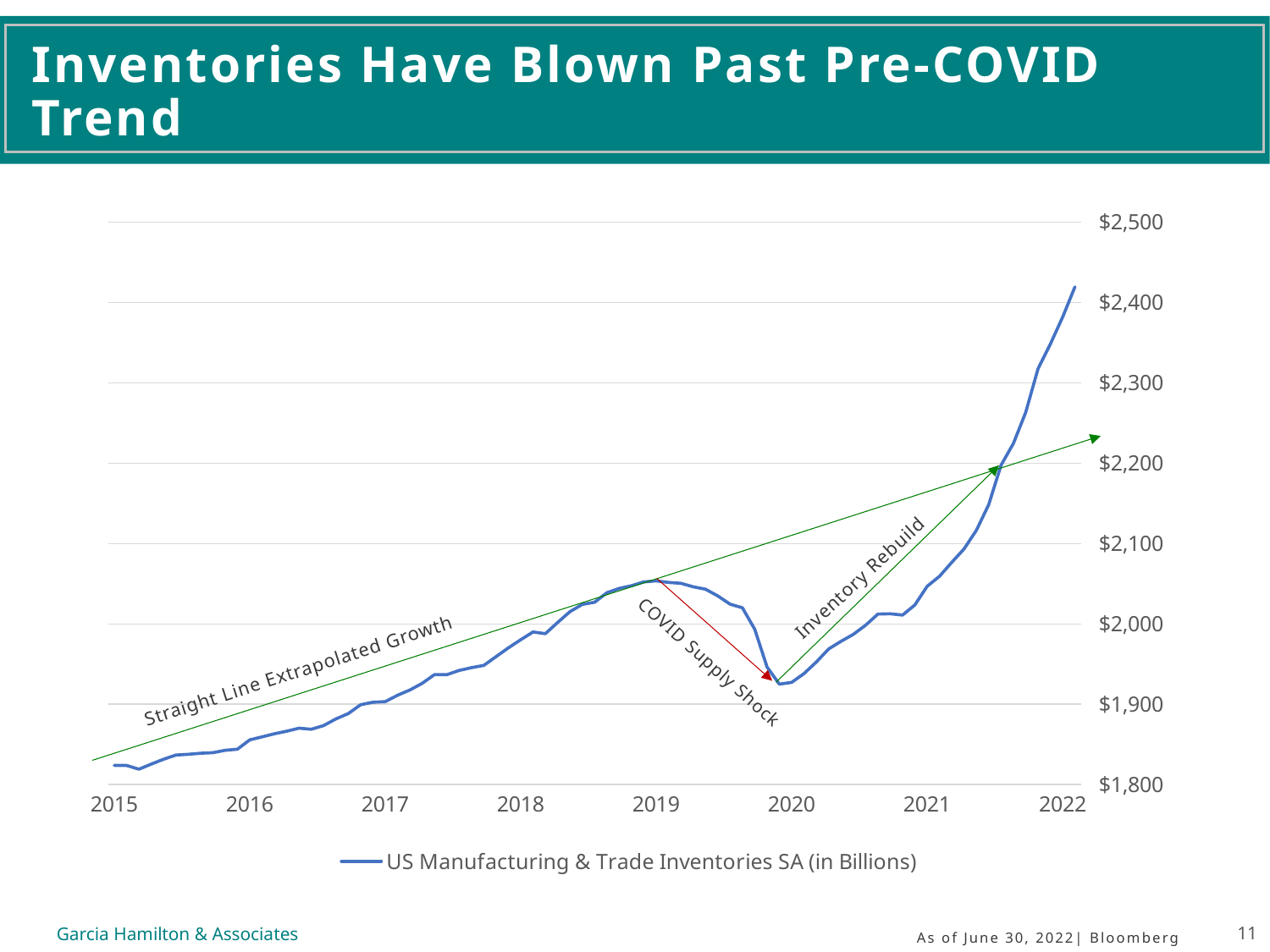
What is the title of the slide containing the chart? Inventories Have Blown Past Pre-COVID Trend Is the value of US Manufacturing & Trade Inventories at the start of 2015 greater or less than $1,900? less Overall, do US Manufacturing & Trade Inventories rise or fall from 2015 to 2022? Rise What series name is shown in the legend? US Manufacturing & Trade Inventories SA (in Billions) What kind of chart is shown on the slide? Line chart How many year labels are shown on the x axis? 8 How many series does the legend list? 1 Is the value of US Manufacturing & Trade Inventories at the end of the line in 2022 greater or less than $2,300? greater In which year does the line reach its highest value? 2022 Which is larger, the inventories value at the start of 2015 or at the end of the line in 2022? 2022 Is the value of US Manufacturing & Trade Inventories at the start of 2019 greater or less than $2,000? greater